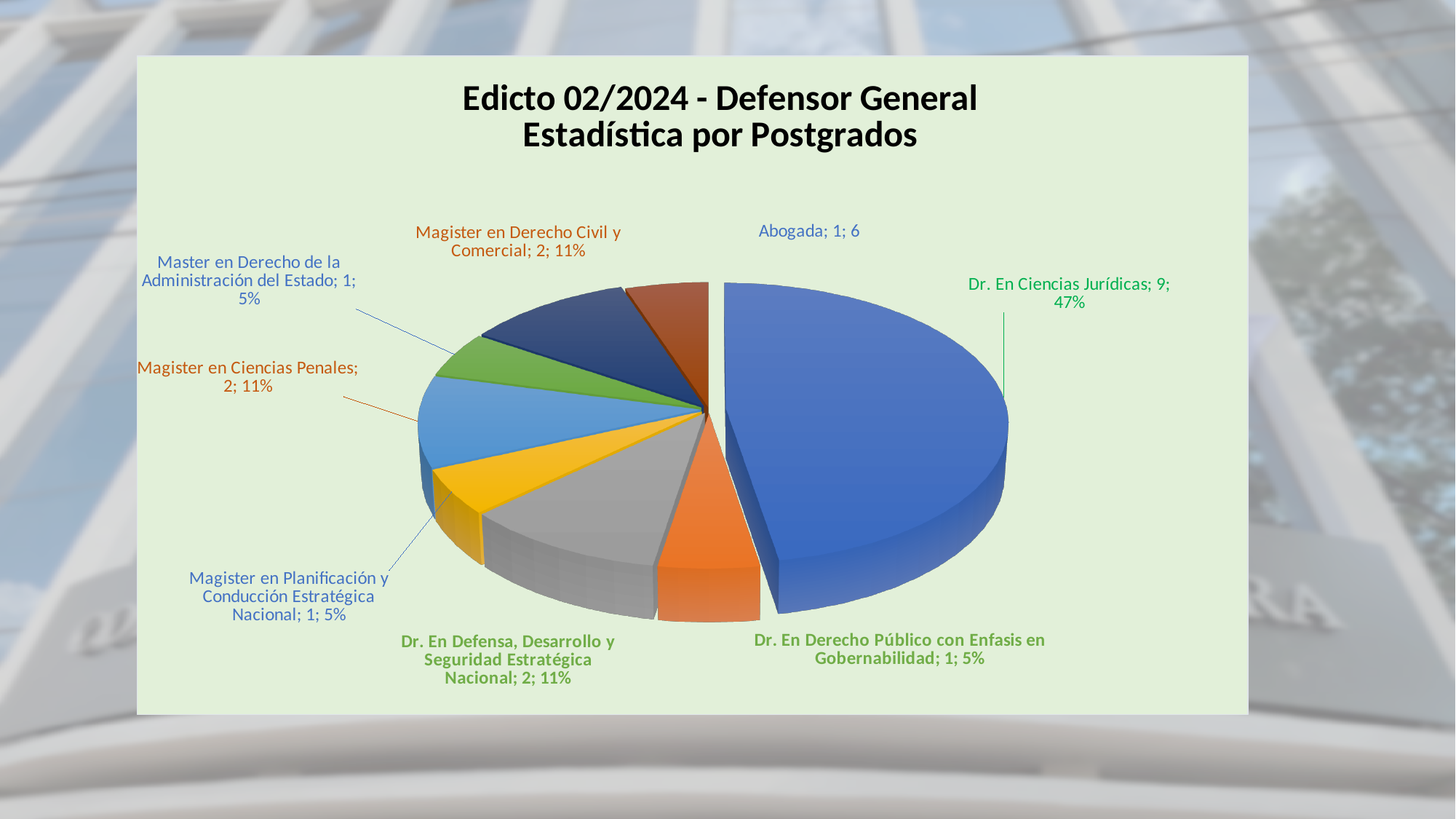
What is the count shown for Dr. En Derecho Público con Enfasis en Gobernabilidad? 1 What is the count shown for Magister en Ciencias Penales? 2 What share of the pie does Master en Derecho de la Administración del Estado represent? 5% What is the title of the chart? Edicto 02/2024 - Defensor General Estadística por Postgrados What kind of chart is shown on the slide? pie chart What share of the pie does Magister en Derecho Civil y Comercial represent? 11% How many slices does the pie chart have? 8 Which category has the largest slice of the pie? Dr. En Ciencias Jurídicas Which has a larger count, Magister en Ciencias Penales or Magister en Planificación y Conducción Estratégica Nacional? Magister en Ciencias Penales What is the count shown for Dr. En Ciencias Jurídicas? 9 What share of the pie does Dr. En Ciencias Jurídicas represent? 47% What is the difference in count between Dr. En Ciencias Jurídicas and Dr. En Defensa, Desarrollo y Seguridad Estratégica Nacional? 7